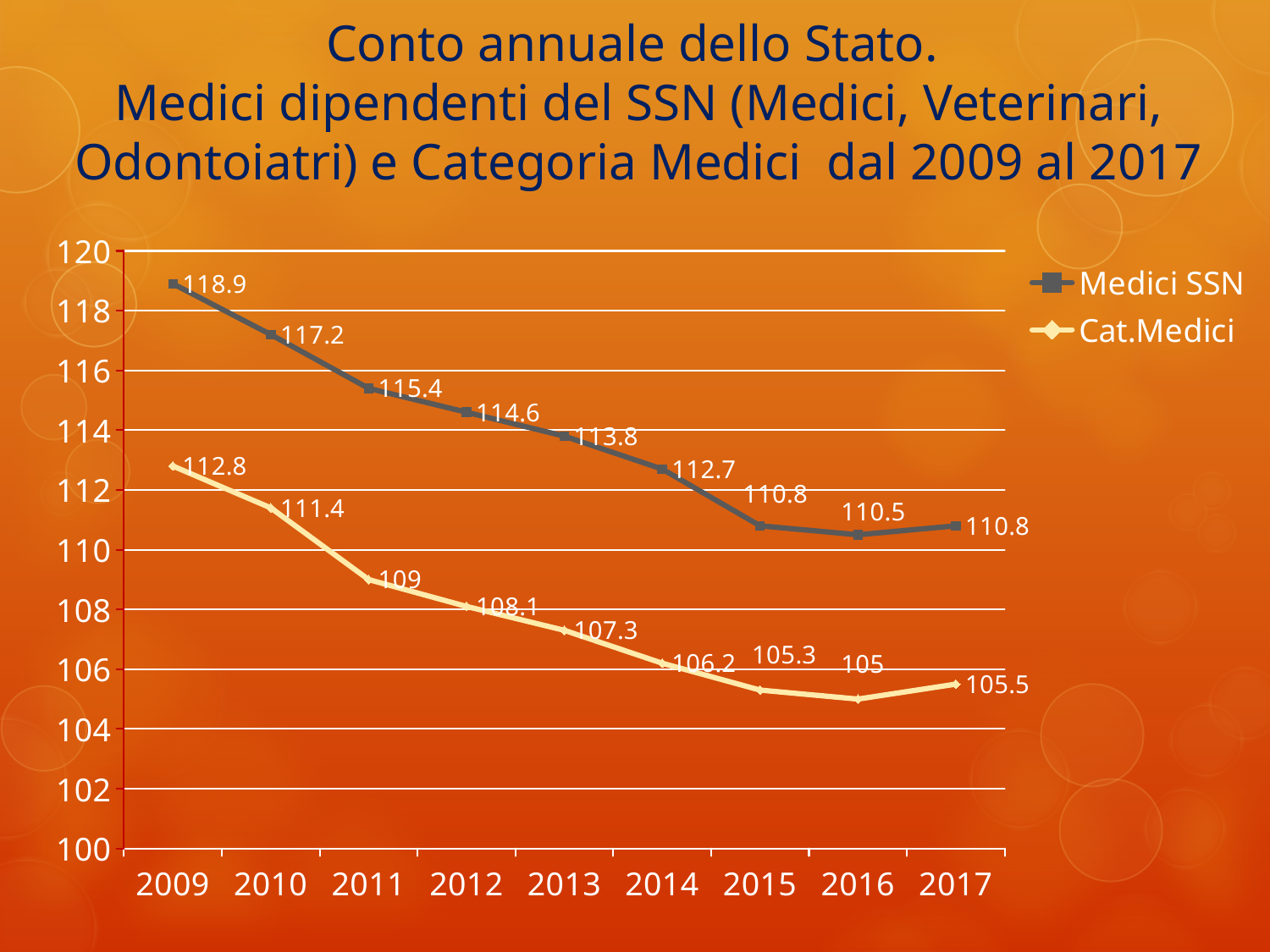
What kind of chart is this? Line chart What is the difference between Medici SSN and Cat.Medici in 2012? 6.5 Does the Medici SSN series generally rise or fall from 2009 to 2015? Fall What is the value for Cat.Medici in 2013? 107.3 How many series does the legend list? 2 What is the value for Medici SSN in 2017? 110.8 How many years are shown on the x axis? 9 What are the two series named in the legend? Medici SSN and Cat.Medici What is the value for Medici SSN in 2009? 118.9 In which year is the Cat.Medici series at its lowest? 2016 Which is larger, the Cat.Medici value in 2011 or in 2014? 2011 In which year is the Medici SSN series at its highest? 2009